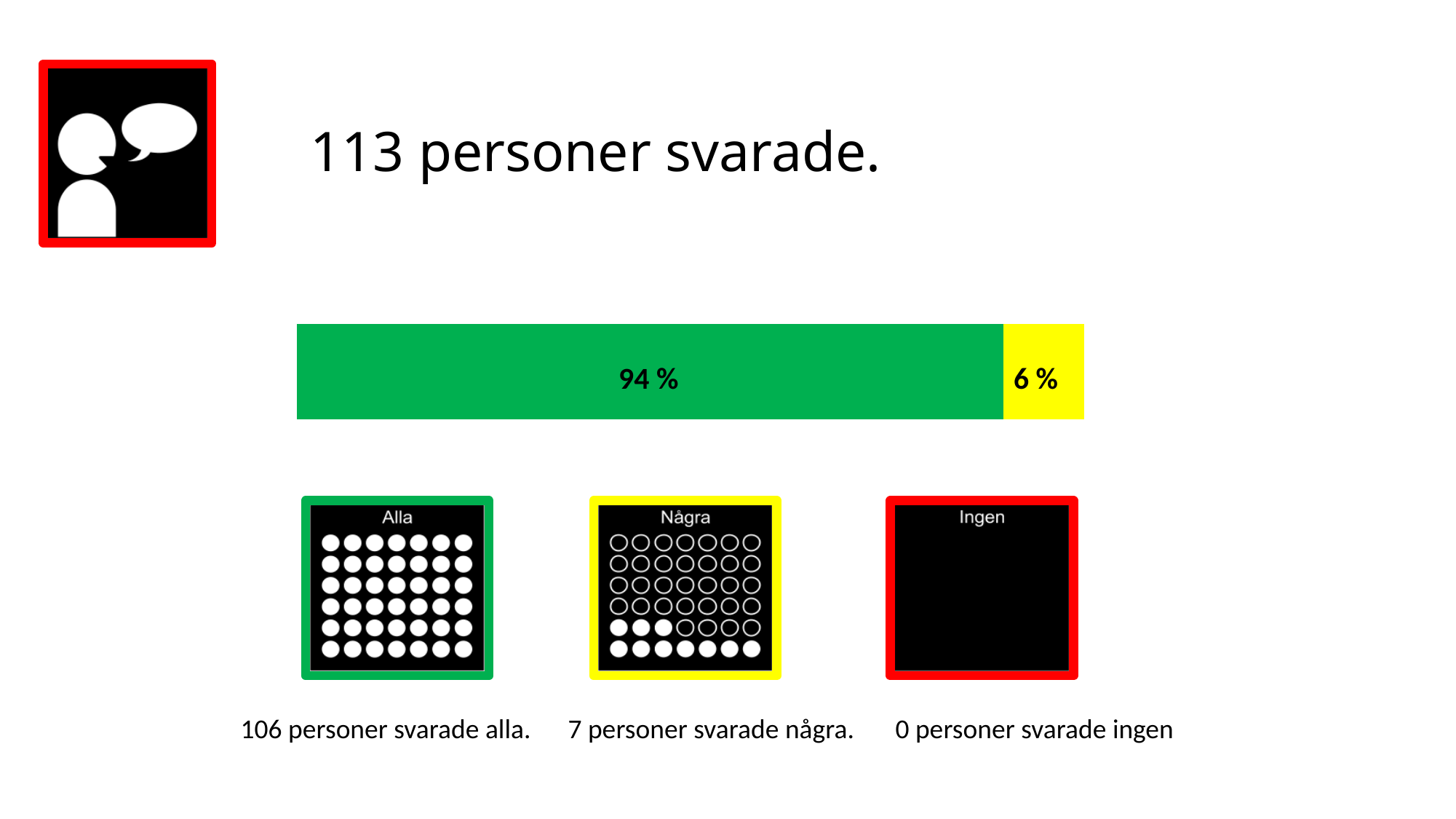
According to the slide, how many people answered 'några'? 7 What percentage is shown on the green segment of the bar? 94 % Which segment of the bar has the largest value? green (94 %) What is the title text at the top of the slide? 113 personer svarade. What is the difference between the green segment's value and the yellow segment's value? 88 % What percentage is shown on the yellow segment of the bar? 6 % What kind of chart is shown on the slide? bar chart Which segment of the bar is larger, the green one or the yellow one? green How many segments does the stacked bar have? 2 What is the total of the two segments in the stacked bar? 100 % Which segment of the bar has the smallest value? yellow (6 %) According to the slide, how many people answered 'alla'? 106